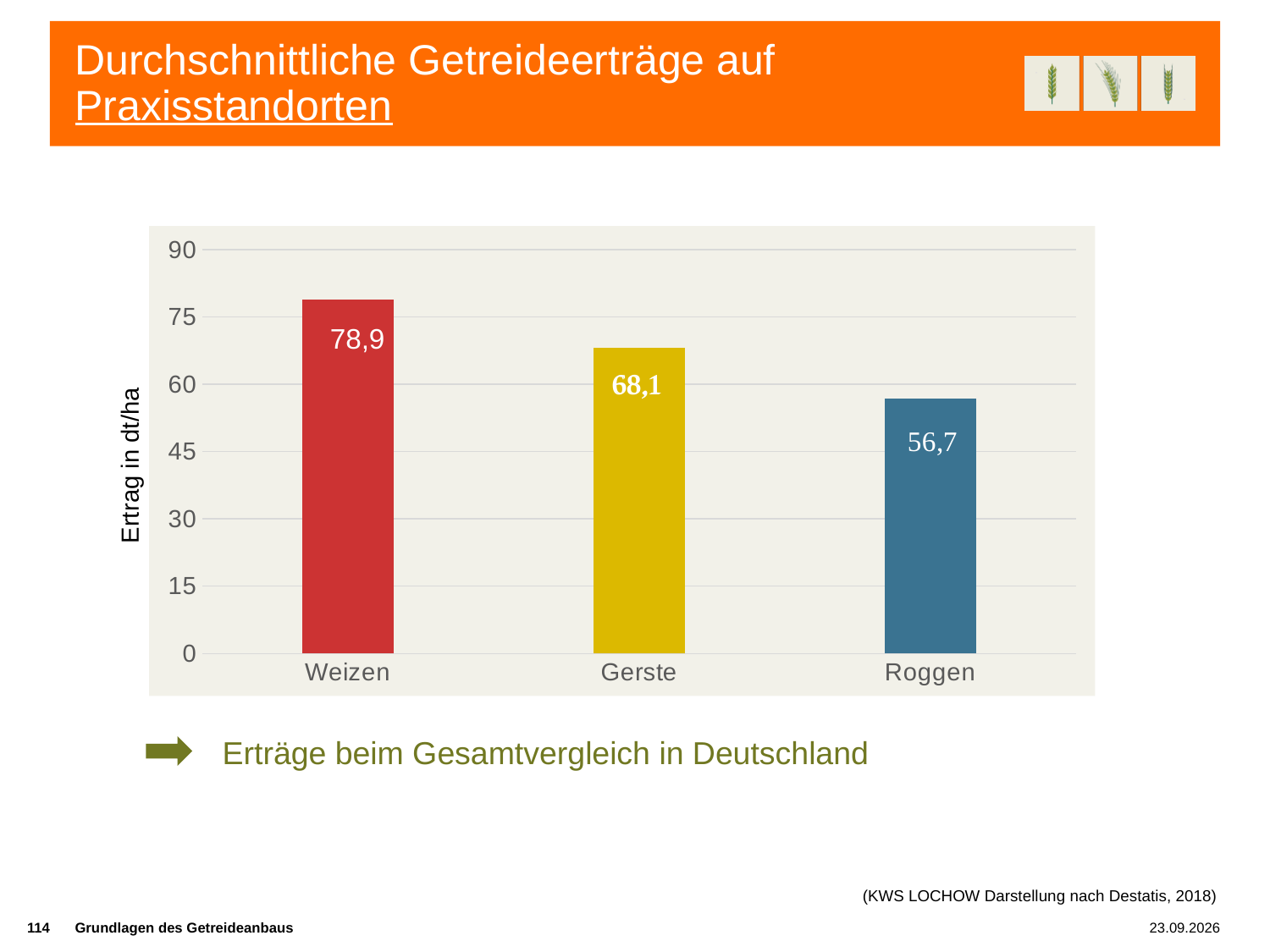
What is the difference between the values for Gerste and Roggen? 11,4 How many categories are shown in the chart? 3 Which is larger, the value for Gerste or the value for Roggen? Gerste What is the label of the y axis? Ertrag in dt/ha Which category has the highest value? Weizen What is the value for Roggen? 56,7 What is the value for Weizen? 78,9 Which category has the lowest value? Roggen What kind of chart is shown on the slide? bar chart What is the difference between the values for Weizen and Roggen? 22,2 What is the value for Gerste? 68,1 Is the value for Roggen greater or less than 60? less